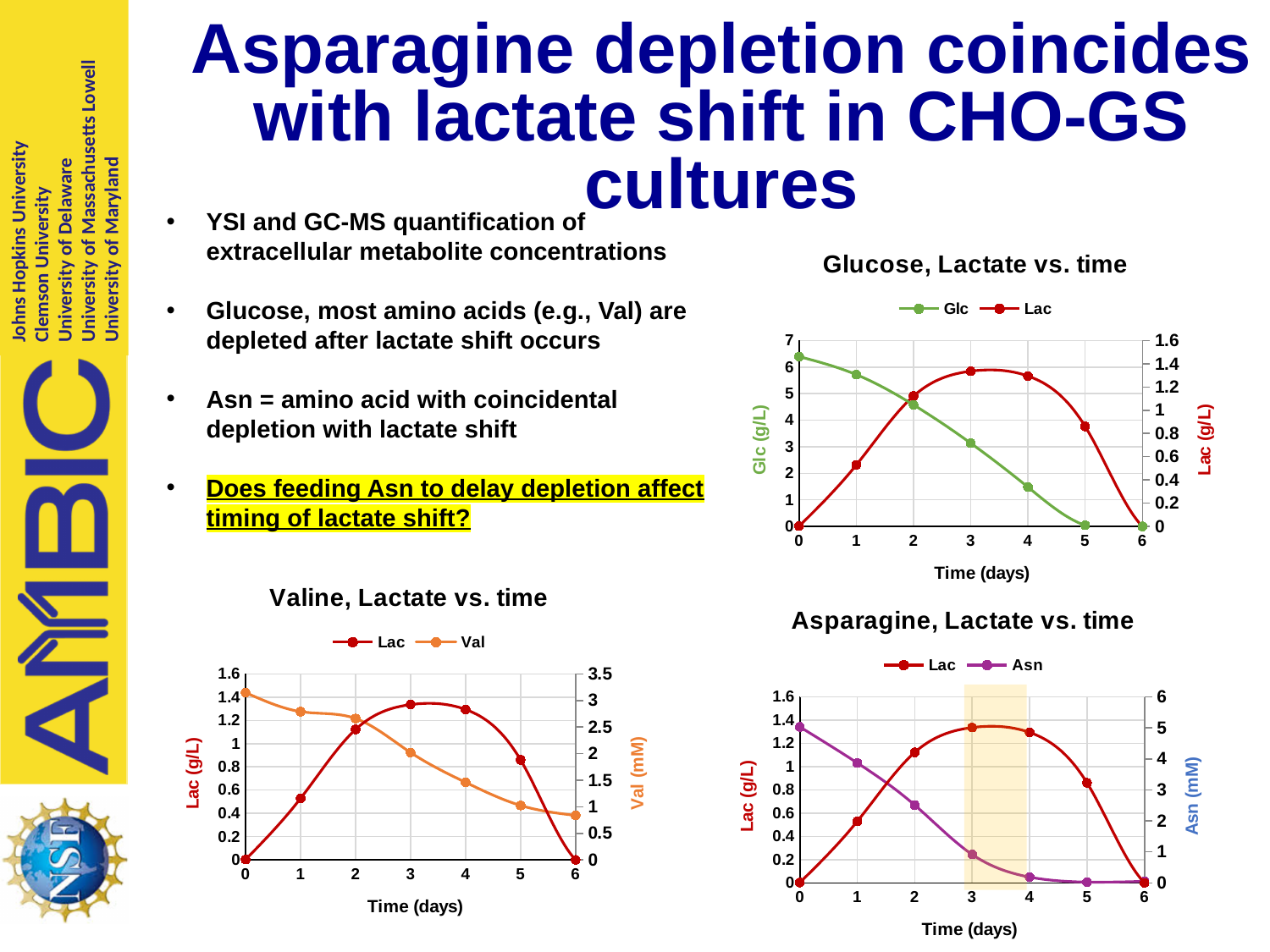
In the "Glucose, Lactate vs. time" chart, at which day is the Glc value highest? 0 What is the label of the right-hand vertical axis in the "Asparagine, Lactate vs. time" chart? Asn (mM) In the "Asparagine, Lactate vs. time" chart, which is larger: the Asn value at day 1 or the Asn value at day 4? day 1 How many series does the legend of the "Asparagine, Lactate vs. time" chart list? 2 In the "Glucose, Lactate vs. time" chart, is the Glc value at day 0 greater or less than 6 g/L? greater In the "Glucose, Lactate vs. time" chart, does the Glc series rise or fall as time increases? fall In the "Valine, Lactate vs. time" chart, is the Val value at day 0 greater or less than 3 mM? greater In the "Valine, Lactate vs. time" chart, how many time points are plotted for the Val series? 7 In the "Valine, Lactate vs. time" chart, is the Val value at day 6 greater or less than 1 mM? less What type of chart is the "Glucose, Lactate vs. time" chart? line chart